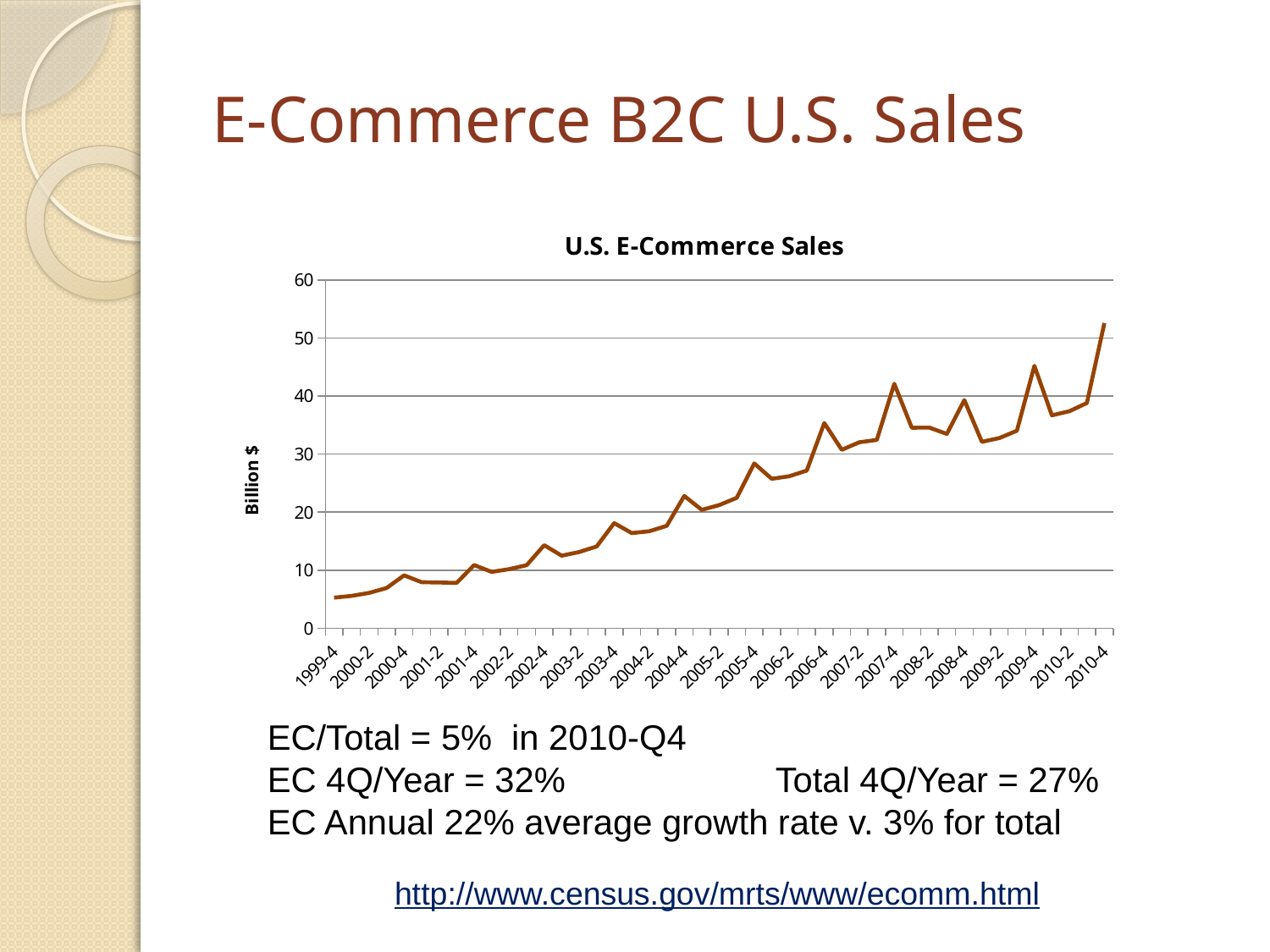
Is the value for 2003-4 greater or less than 20? less What is the label on the vertical axis of the chart? Billion $ Which quarter has the lowest value on the chart? 1999-4 Is the value for 1999-4 greater or less than 10? less Is the value for 2004-4 greater or less than 20? greater Which quarter has the highest value on the chart? 2010-4 What is the title of the chart? U.S. E-Commerce Sales Do the values generally rise or fall from 1999-4 to 2010-4? rise Which is larger, the value for 2010-4 or the value for 2009-4? 2010-4 What kind of chart is shown on the slide? line chart